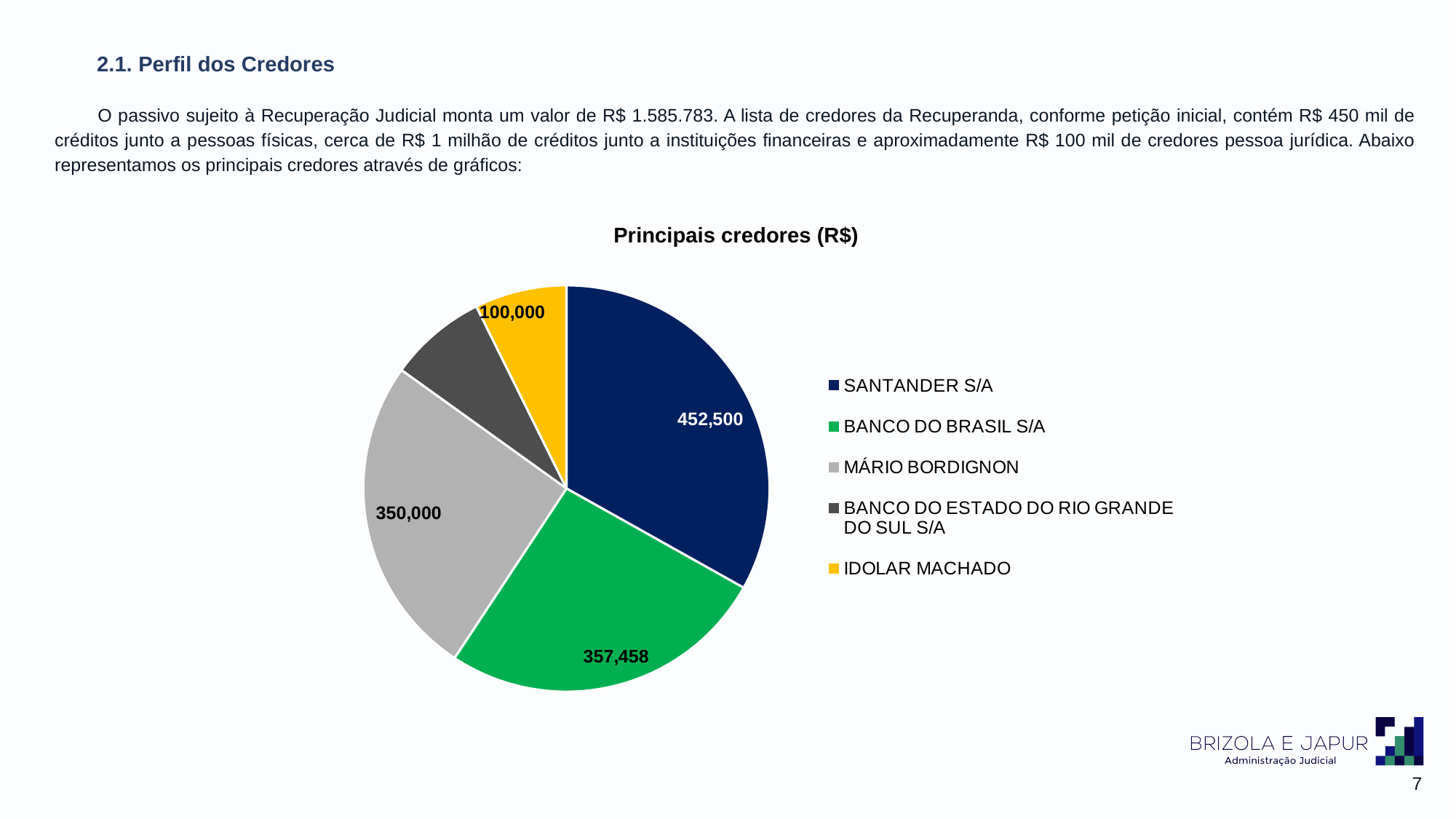
What is the value shown for BANCO DO BRASIL S/A? 357,458 What is the difference between the values for SANTANDER S/A and BANCO DO BRASIL S/A? 95,042 How many creditors are shown in the pie chart? 5 What colour is the slice for IDOLAR MACHADO? Yellow What is the difference between the values for MÁRIO BORDIGNON and IDOLAR MACHADO? 250,000 What is the value shown for SANTANDER S/A in the pie chart? 452,500 What is the value shown for IDOLAR MACHADO? 100,000 What is the value shown for MÁRIO BORDIGNON? 350,000 Which creditor has the largest slice in the pie chart? SANTANDER S/A What is the title of the chart? Principais credores (R$) Which is larger, the value for BANCO DO BRASIL S/A or the value for MÁRIO BORDIGNON? BANCO DO BRASIL S/A What kind of chart is shown on the slide? Pie chart